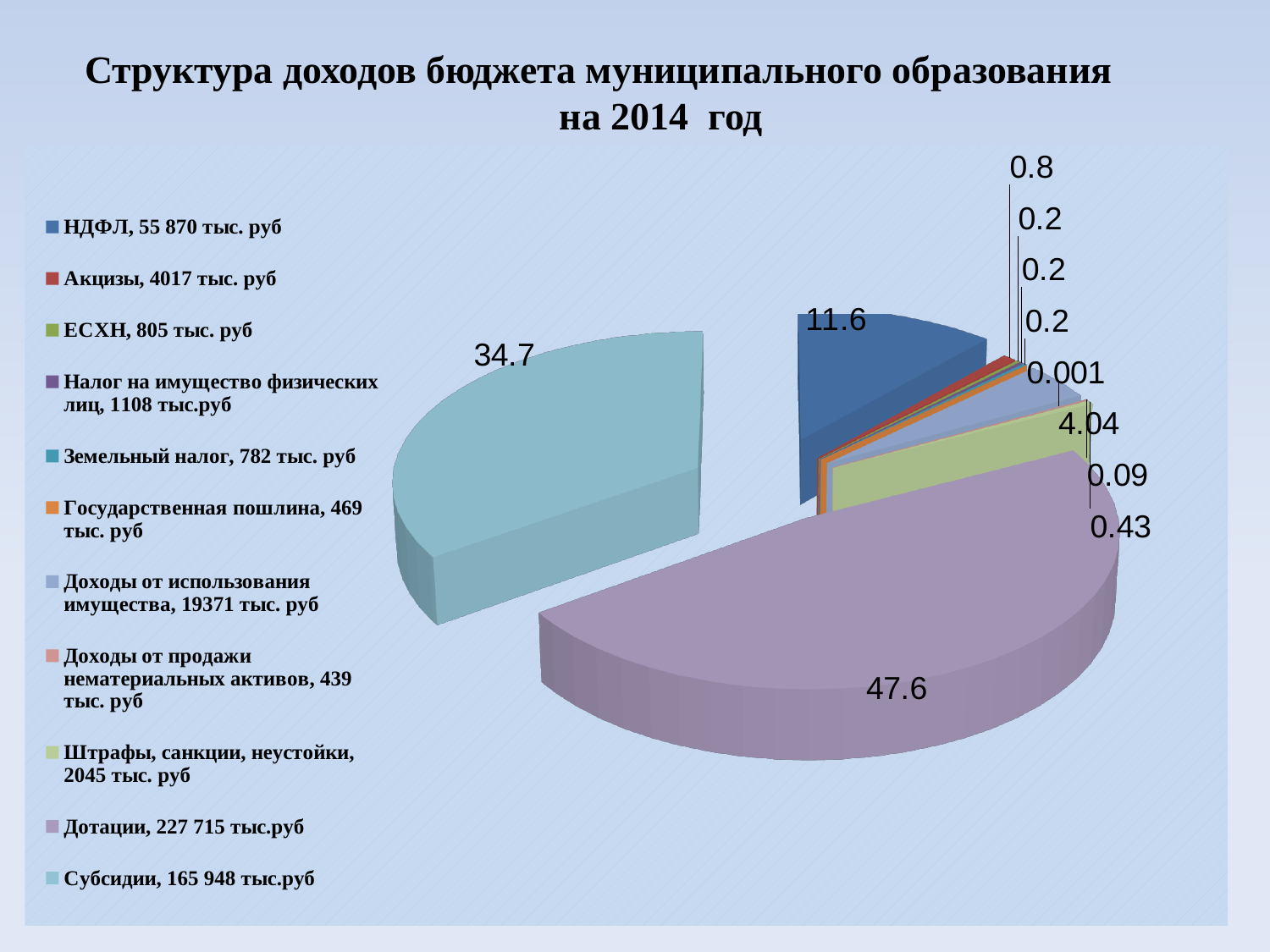
What is the data label on the НДФЛ slice of the pie chart? 11.6 What kind of chart is shown on the slide? Pie chart What is the difference between the data labels of the Субсидии slice (34.7) and the НДФЛ slice (11.6)? 23.1 What is the data label on the largest slice of the pie chart (Дотации)? 47.6 According to the legend, what amount is given for Дотации? 227 715 тыс.руб Which slice is larger: Дотации or Субсидии? Дотации How many categories does the legend of the pie chart list? 11 What is the title of the chart on the slide? Структура доходов бюджета муниципального образования на 2014 год Which category has the largest slice of the pie chart? Дотации What is the data label on the Субсидии slice of the pie chart? 34.7 Which slice is larger: НДФЛ or Субсидии? Субсидии What is the difference between the data labels of the Дотации slice (47.6) and the Субсидии slice (34.7)? 12.9